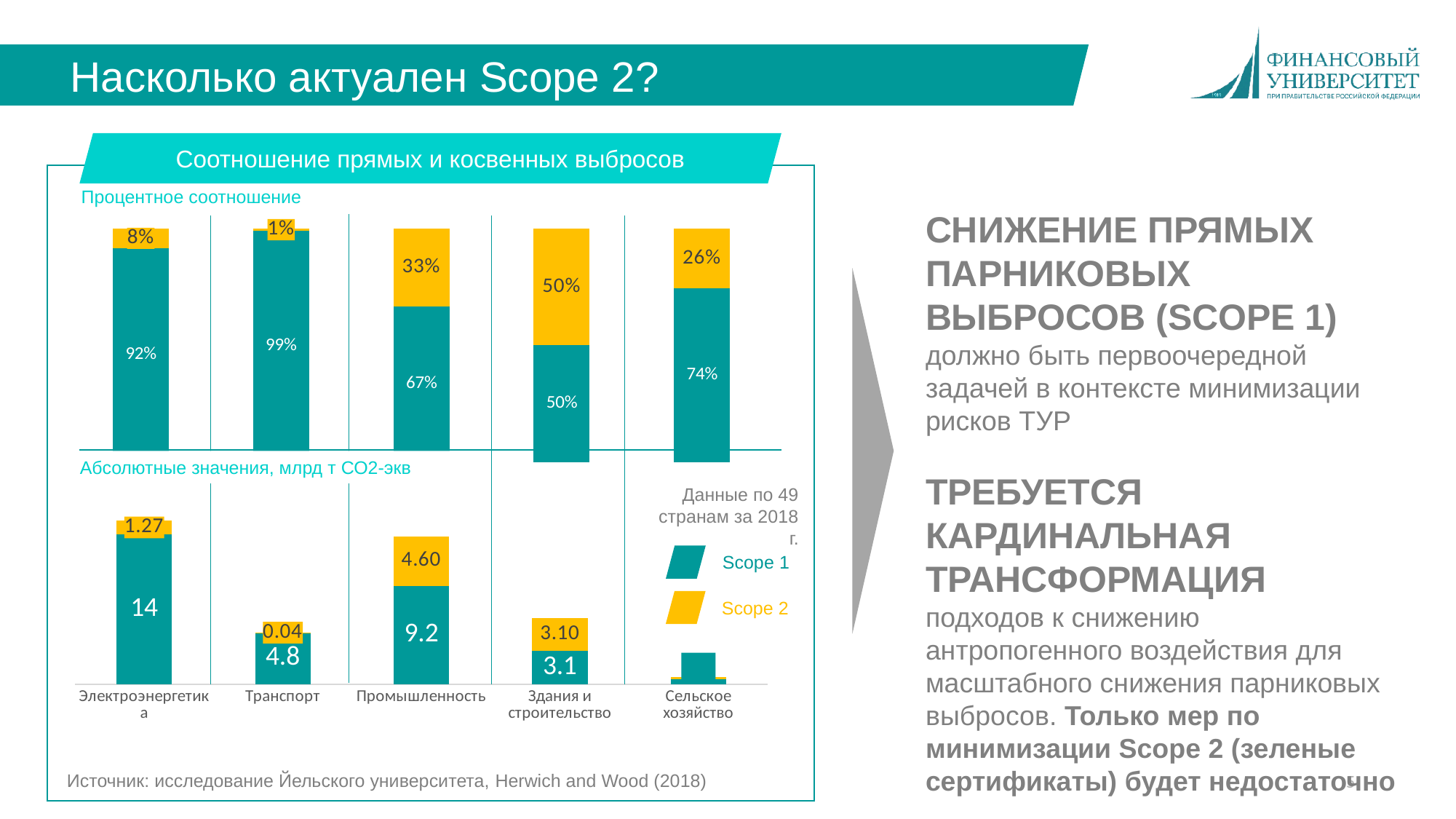
In the 'Процентное соотношение' chart, what is the Scope 1 share for Промышленность? 67% In the 'Абсолютные значения, млрд т CO2-экв' chart, what is the total of the stacked bar for Здания и строительство? 6.2 How many series does the legend list for the charts on the slide? 2 In the 'Абсолютные значения, млрд т CO2-экв' chart, which is larger: the Scope 1 value for Промышленность or for Транспорт? Промышленность How many categories are shown on the x axis of the 'Абсолютные значения, млрд т CO2-экв' chart? 5 In the 'Процентное соотношение' chart, which category has the highest Scope 2 share? Здания и строительство In the 'Абсолютные значения, млрд т CO2-экв' chart, what is the Scope 2 value for Транспорт? 0.04 In the 'Процентное соотношение' chart, what is the difference between the Scope 1 shares of Транспорт and Электроэнергетика? 7% In the 'Абсолютные значения, млрд т CO2-экв' chart, what is the Scope 1 value for Электроэнергетика? 14 In the 'Процентное соотношение' chart, which category has the lowest Scope 2 share? Транспорт In the 'Абсолютные значения, млрд т CO2-экв' chart, what is the Scope 2 value for Промышленность? 4.60 In the 'Процентное соотношение' chart, what is the Scope 2 share for Сельское хозяйство? 26%